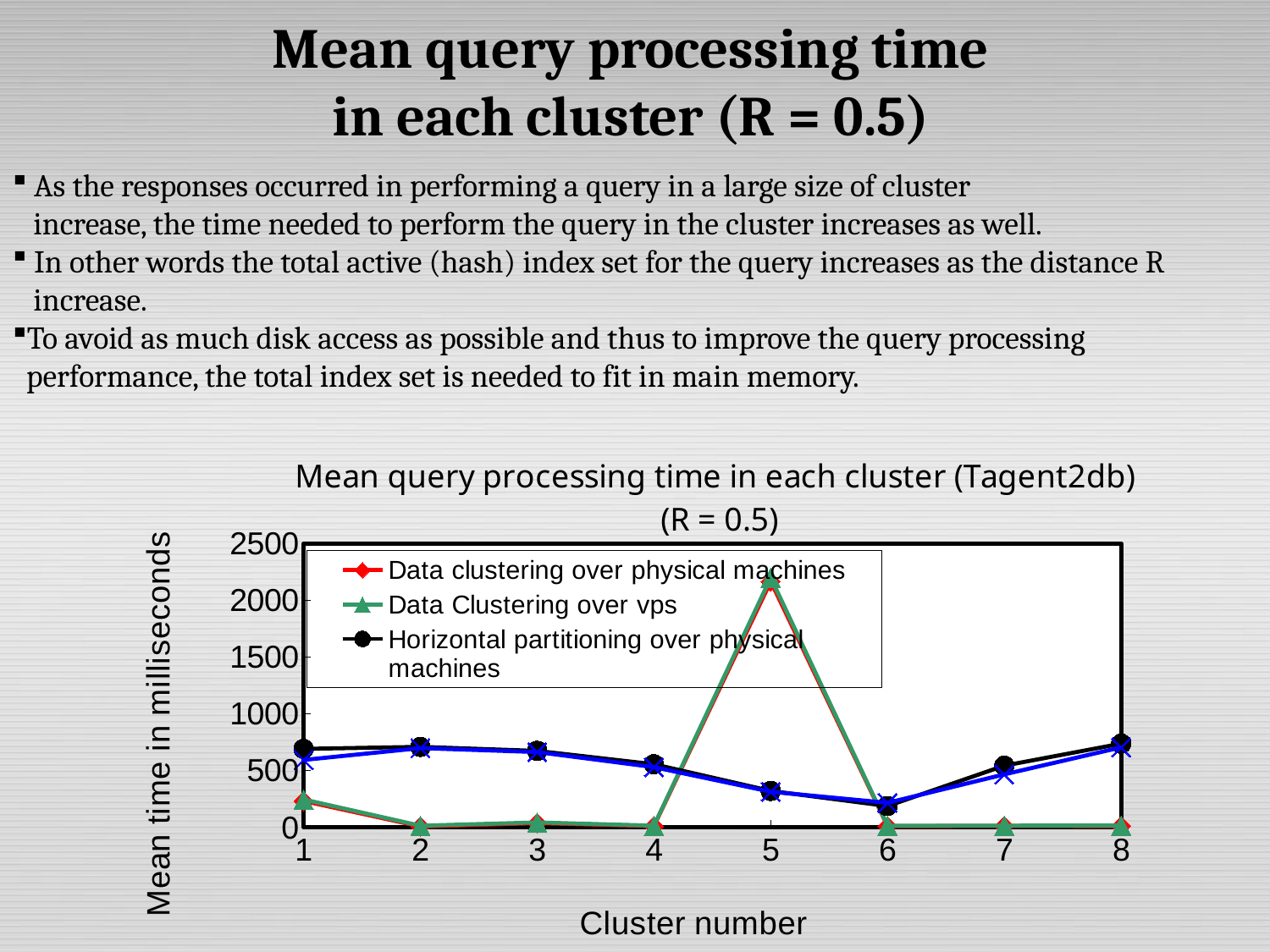
At cluster 5, which is larger: Data Clustering over vps or Horizontal partitioning over physical machines? Data Clustering over vps How many cluster numbers are plotted along the x axis? 8 At which cluster number does Data Clustering over vps reach its highest value? 5 Is the value for Data clustering over physical machines at cluster 1 greater or less than 500? less Is the value for Data Clustering over vps at cluster 5 greater or less than 2000? greater Does the Horizontal partitioning over physical machines series rise or fall from cluster 2 to cluster 6? fall How many series does the chart's legend list? 3 At which cluster number is Horizontal partitioning over physical machines lowest? 6 Is the value for Horizontal partitioning over physical machines at cluster 1 greater or less than 500? greater What is the label of the chart's y axis? Mean time in milliseconds What kind of chart is shown on the slide? line chart